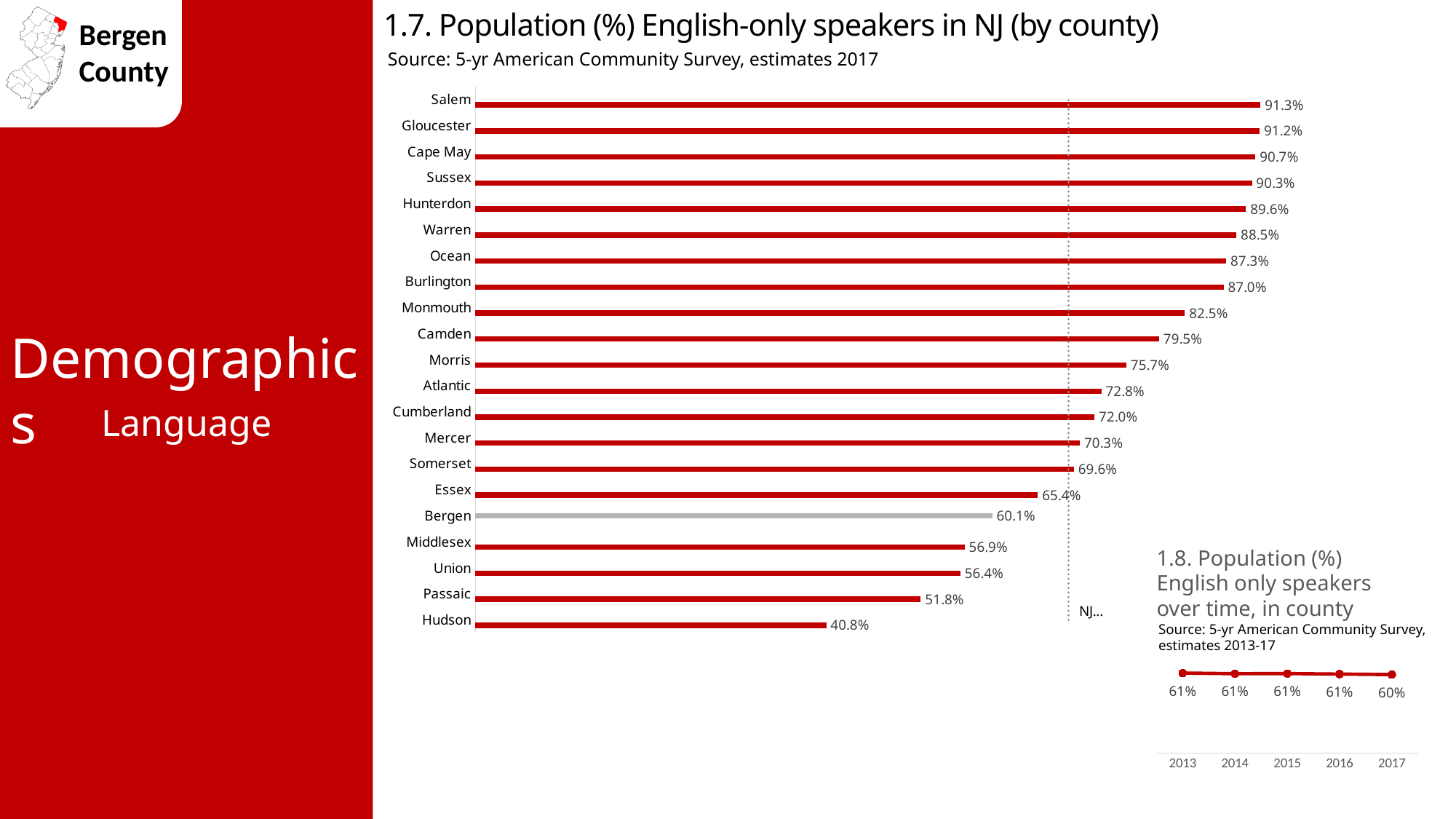
In chart 1.8, do the values rise or fall from 2013 to 2017? Fall In chart 1.7, which county has the highest percentage of English-only speakers? Salem In chart 1.8, how many years are plotted? 5 In chart 1.7, what percentage of Salem's population are English-only speakers? 91.3% In chart 1.7, what is the value shown for Bergen? 60.1% In chart 1.7, which county has a higher value, Passaic or Union? Union In chart 1.7, how many counties are plotted? 21 What kind of chart is chart 1.7? Bar chart In chart 1.8, what is the value shown for 2017? 60% In chart 1.7, which county has the lowest percentage of English-only speakers? Hudson In chart 1.7, which county's bar is shown in grey rather than red? Bergen In chart 1.7, what is the difference between the values for Essex and Bergen? 5.3%